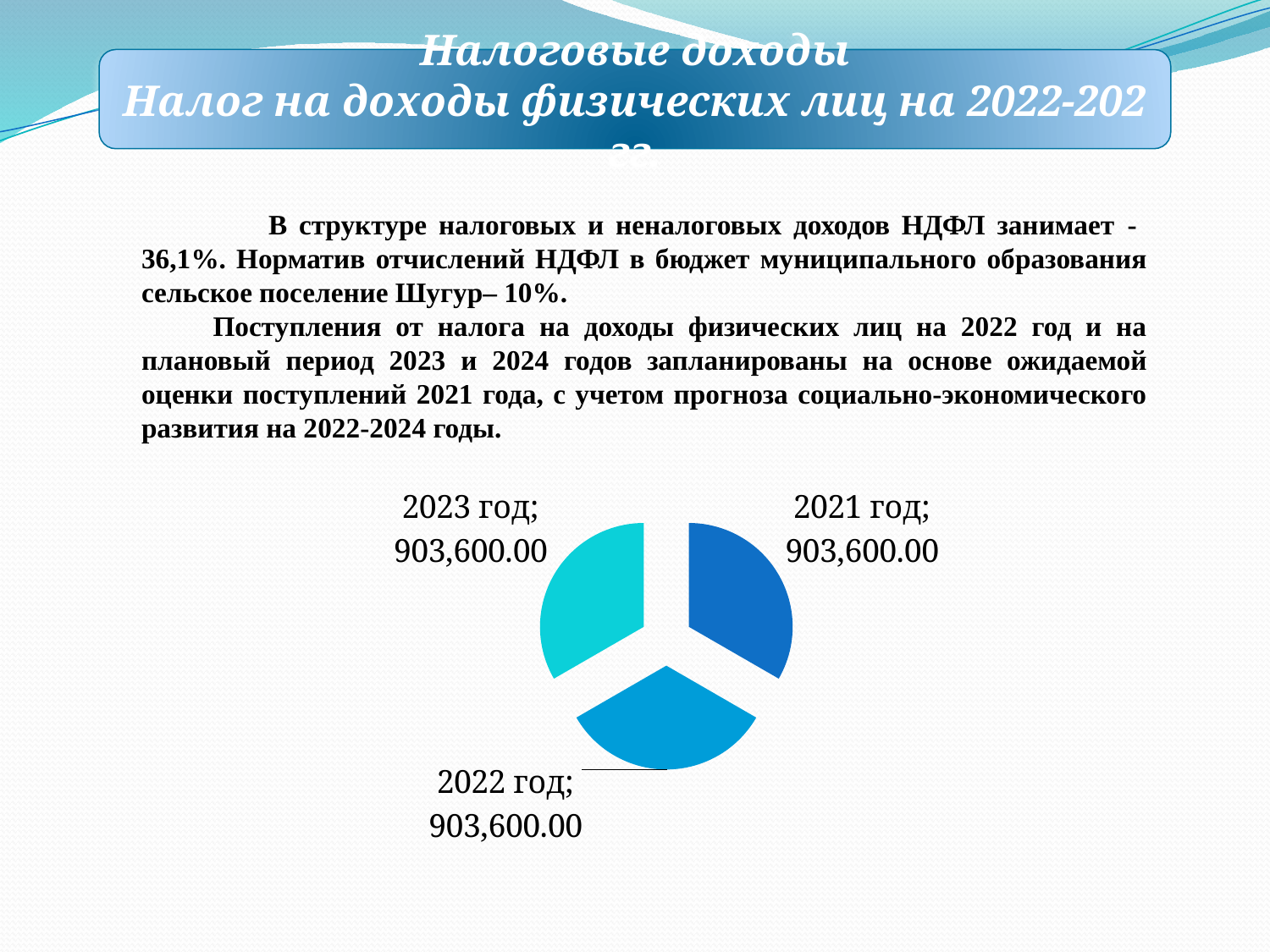
How many slices does the pie chart have? 3 What is the value shown for 2023 год in the pie chart? 903,600.00 What is the value shown for 2022 год in the pie chart? 903,600.00 What is the value shown for 2021 год in the pie chart? 903,600.00 Are the values for 2021 год, 2022 год and 2023 год in the pie chart equal or different? equal What is the difference between the values for 2021 год and 2023 год in the pie chart? 0 Which slice of the pie chart is coloured dark blue? 2021 год What kind of chart is shown on the slide? pie chart Which years are labelled on the pie chart? 2021 год, 2022 год, 2023 год What is the total of the three values shown in the pie chart? 2,710,800.00